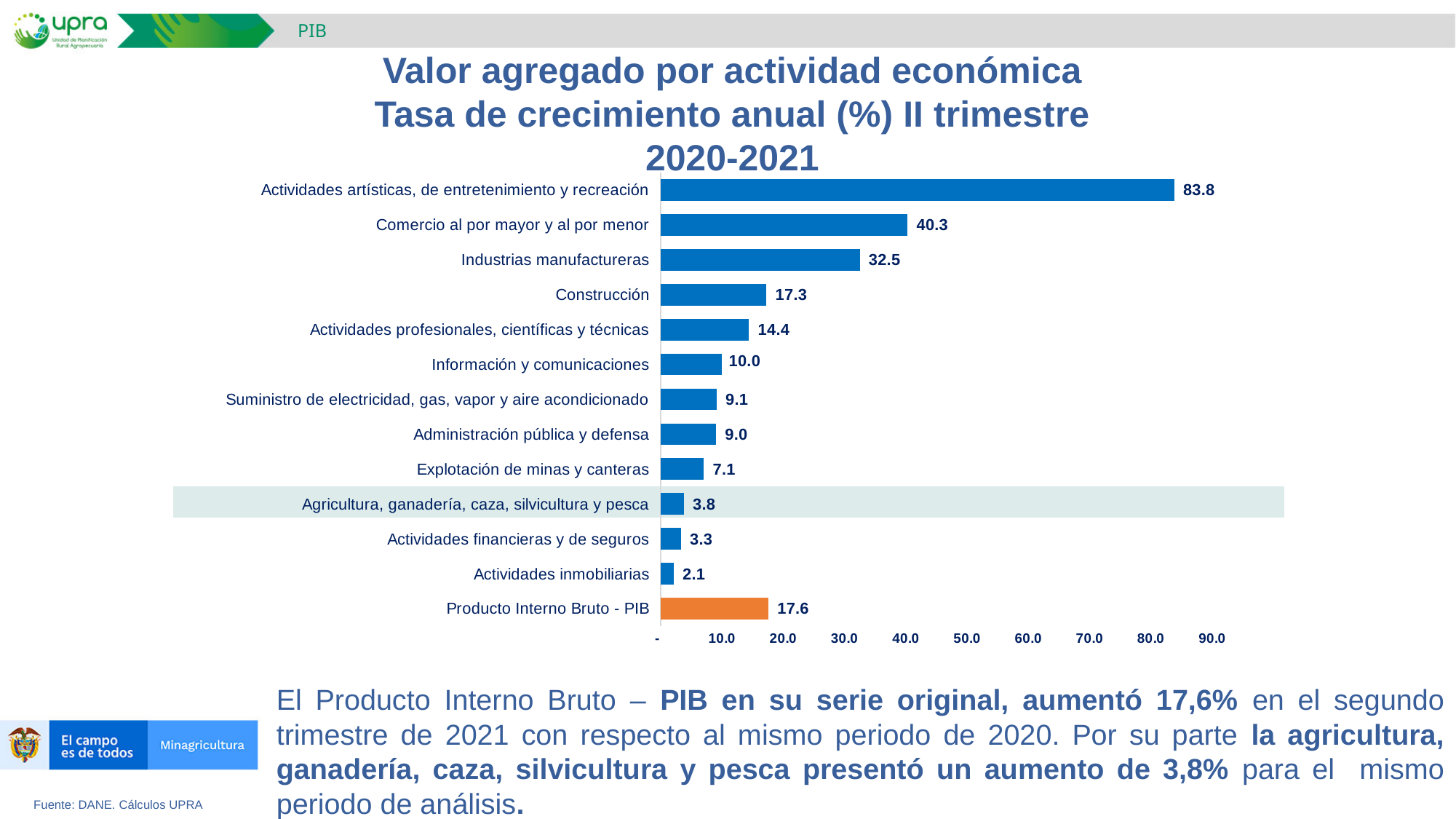
Which is larger, the value for Construcción or the value for Producto Interno Bruto - PIB? Producto Interno Bruto - PIB Which activity has the highest growth rate on the chart? Actividades artísticas, de entretenimiento y recreación What is the difference between the values for Industrias manufactureras and Construcción? 15.2 Which bar on the chart is coloured orange instead of blue? Producto Interno Bruto - PIB Is the value for Actividades artísticas, de entretenimiento y recreación greater or less than 80.0? greater What is the annual growth rate shown for Comercio al por mayor y al por menor? 40.3 What value is shown for Agricultura, ganadería, caza, silvicultura y pesca? 3.8 What is the value shown for Producto Interno Bruto - PIB? 17.6 How many bars are plotted on the chart? 13 Which activity has the lowest growth rate on the chart? Actividades inmobiliarias What type of chart is shown on the slide? bar chart What is the difference between the value for Suministro de electricidad, gas, vapor y aire acondicionado and Administración pública y defensa? 0.1